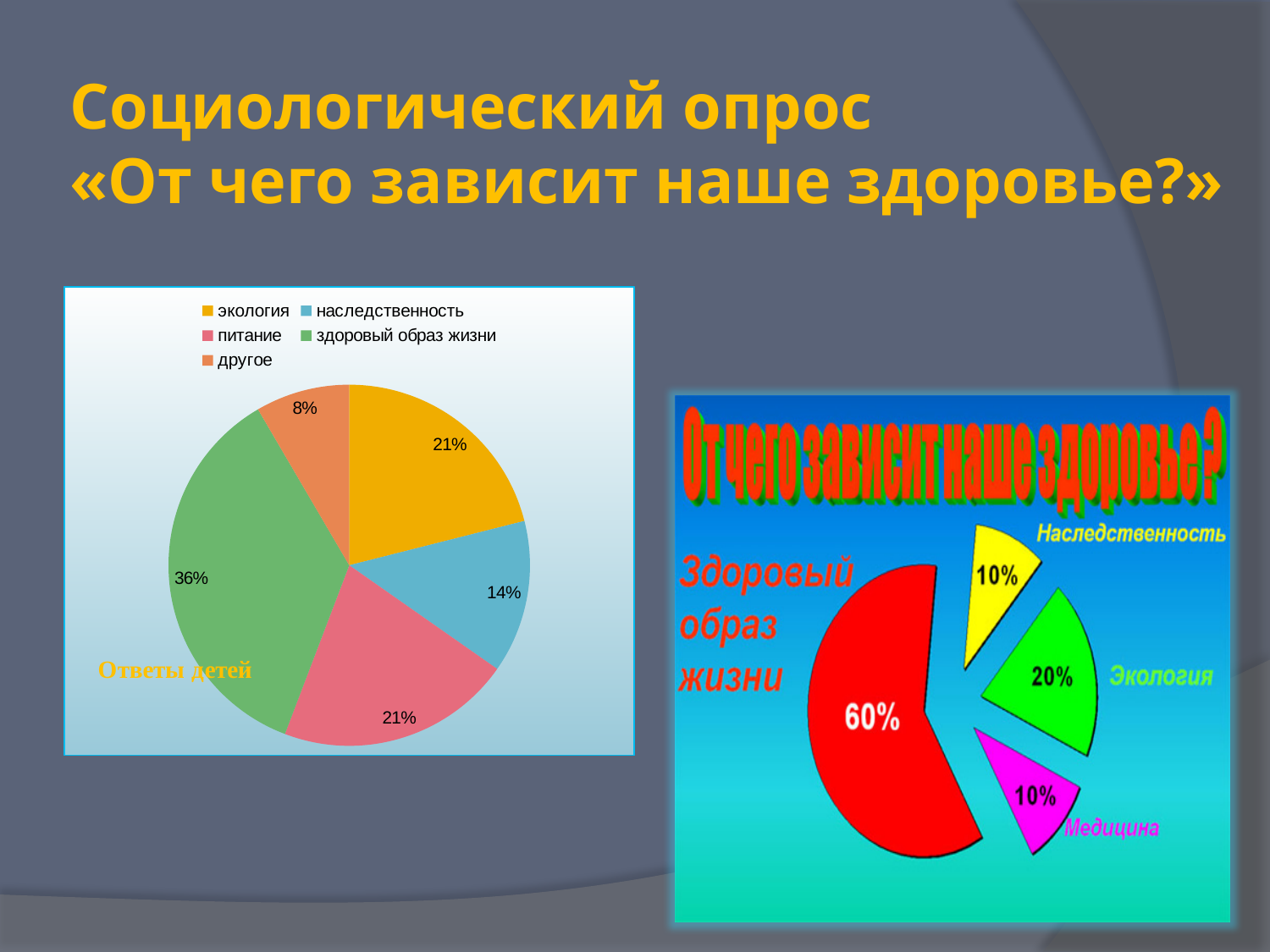
On the left pie chart (Ответы детей), what is the difference between the shares for здоровый образ жизни and наследственность? 22% On the left pie chart (Ответы детей), what share is shown for другое? 8% On the left pie chart (Ответы детей), which category has the smallest share? другое On the right pie chart (От чего зависит наше здоровье?), which category has the largest share? Здоровый образ жизни On the left pie chart (Ответы детей), what share is shown for здоровый образ жизни? 36% On the left pie chart (Ответы детей), what share is shown for наследственность? 14% On the left pie chart (Ответы детей), which category has the largest share? здоровый образ жизни On the right pie chart (От чего зависит наше здоровье?), what share is shown for Здоровый образ жизни? 60% On the left pie chart (Ответы детей), how many categories does the legend list? 5 On the right pie chart (От чего зависит наше здоровье?), how many slices are there? 4 On the right pie chart (От чего зависит наше здоровье?), what share is shown for Экология? 20% What kind of chart is the chart on the left of the slide? pie chart